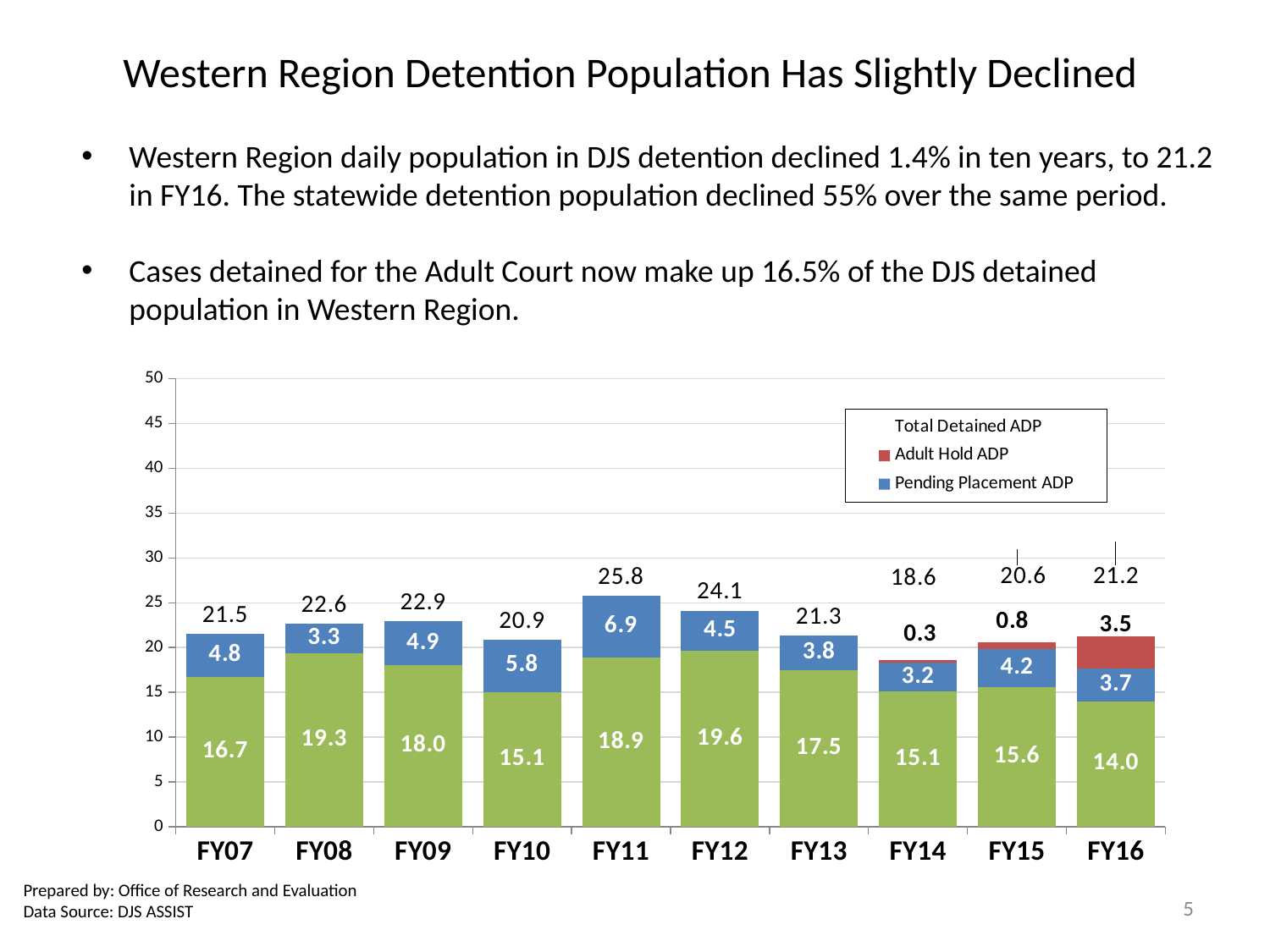
What is the value of the bottom green segment for FY16? 14.0 Which is larger, the Pending Placement ADP in FY10 or in FY12? FY10 How many entries does the legend list? 3 What is the Total Detained ADP for FY16? 21.2 How many fiscal years are shown on the x axis? 10 What is the Adult Hold ADP value for FY15? 0.8 Which fiscal year has the highest Total Detained ADP? FY11 What kind of chart is shown on the slide? Stacked bar chart What is the Pending Placement ADP value for FY11? 6.9 What is the difference between the Total Detained ADP in FY11 and FY14? 7.2 Which fiscal year has the lowest Total Detained ADP? FY14 What colour represents Adult Hold ADP in the chart? Red